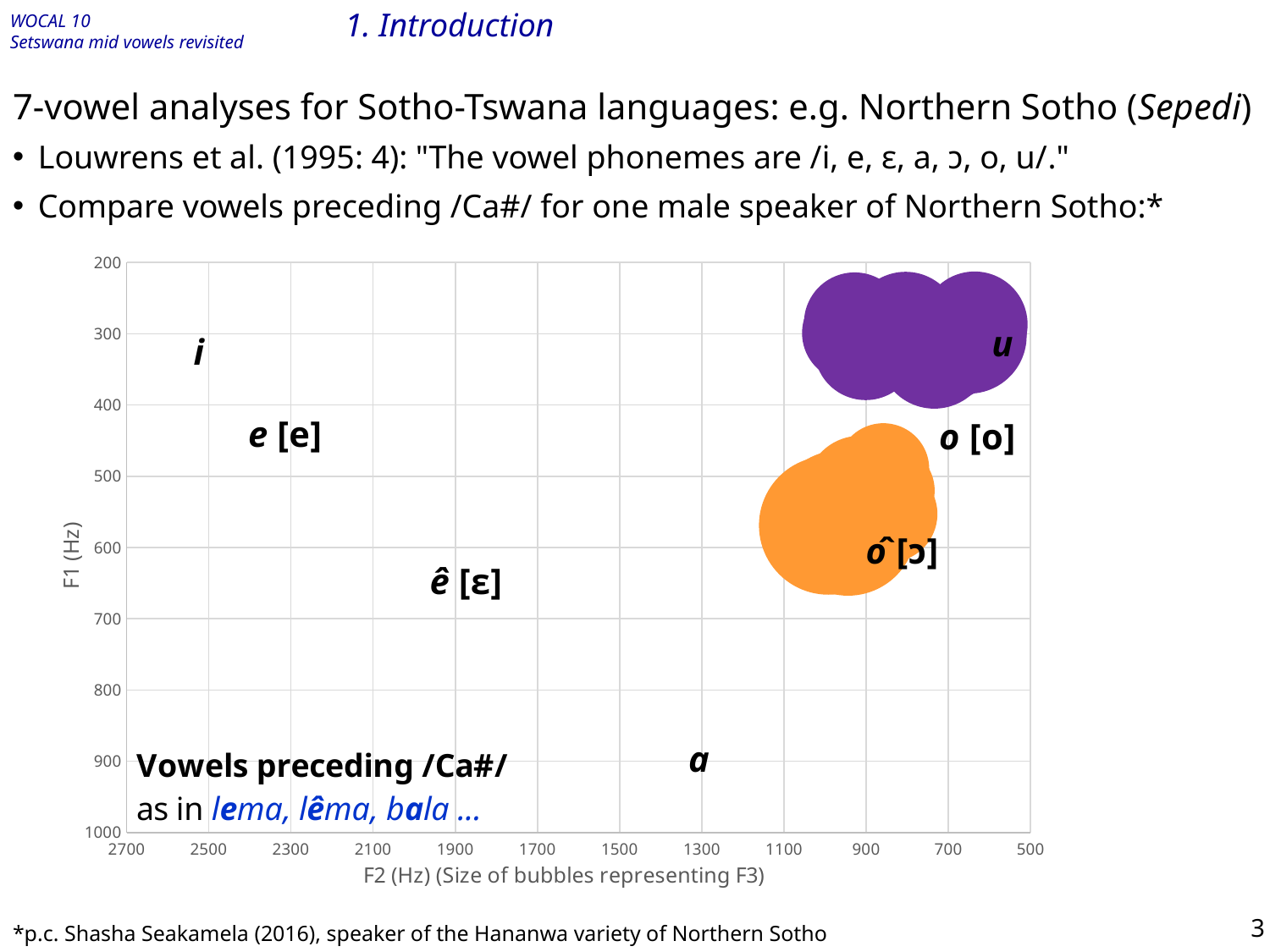
Is the F2 value of the orange bubbles (vowel ô [ɔ]) greater or less than 1300? less How many vowel labels are plotted on the chart? 7 What does the vertical axis of the chart represent? F1 (Hz) Is the F2 value of the purple bubbles (vowel u) greater or less than 1500? less Is the F1 value of the orange bubbles (vowel ô [ɔ]) greater or less than 500? greater Which has the higher F1 value, the vowel ô [ɔ] or the vowel u? ô [ɔ] Which vowel label is plotted with the highest F1 value (lowest on the chart)? a According to the x-axis label, what does the size of the bubbles represent? F3 What is the highest F2 value shown on the x-axis? 2700 What kind of chart is shown on the slide? bubble chart Which vowel label is plotted with the highest F2 value (furthest left on the chart)? i